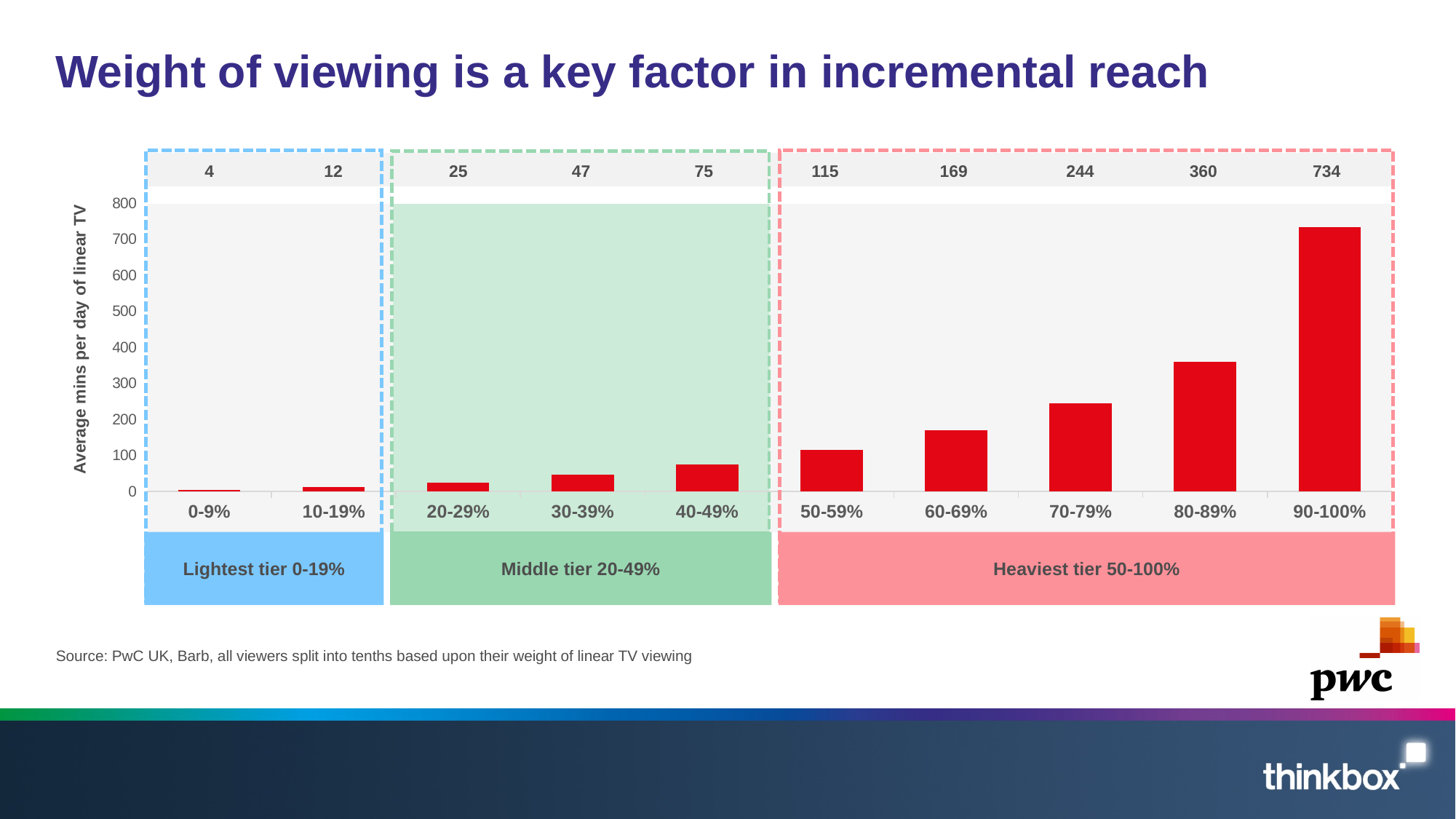
Which is larger, the value for 60-69% or the value for 70-79%? 70-79% What is the value shown for the 0-9% group? 4 What is the value shown for the 30-39% group? 47 Is the value for the 80-89% group greater or less than 300? greater What kind of chart is shown on the slide? Bar chart Do the values rise or fall moving from left to right along the x axis? Rise What is the difference between the values for the 90-100% and 80-89% groups? 374 How many viewer groups are shown on the x axis? 10 What is the average minutes per day of linear TV for the 90-100% group? 734 What is the difference between the values for the 40-49% and 20-29% groups? 50 Which group has the highest average minutes per day of linear TV? 90-100% Which group has the lowest average minutes per day of linear TV? 0-9%